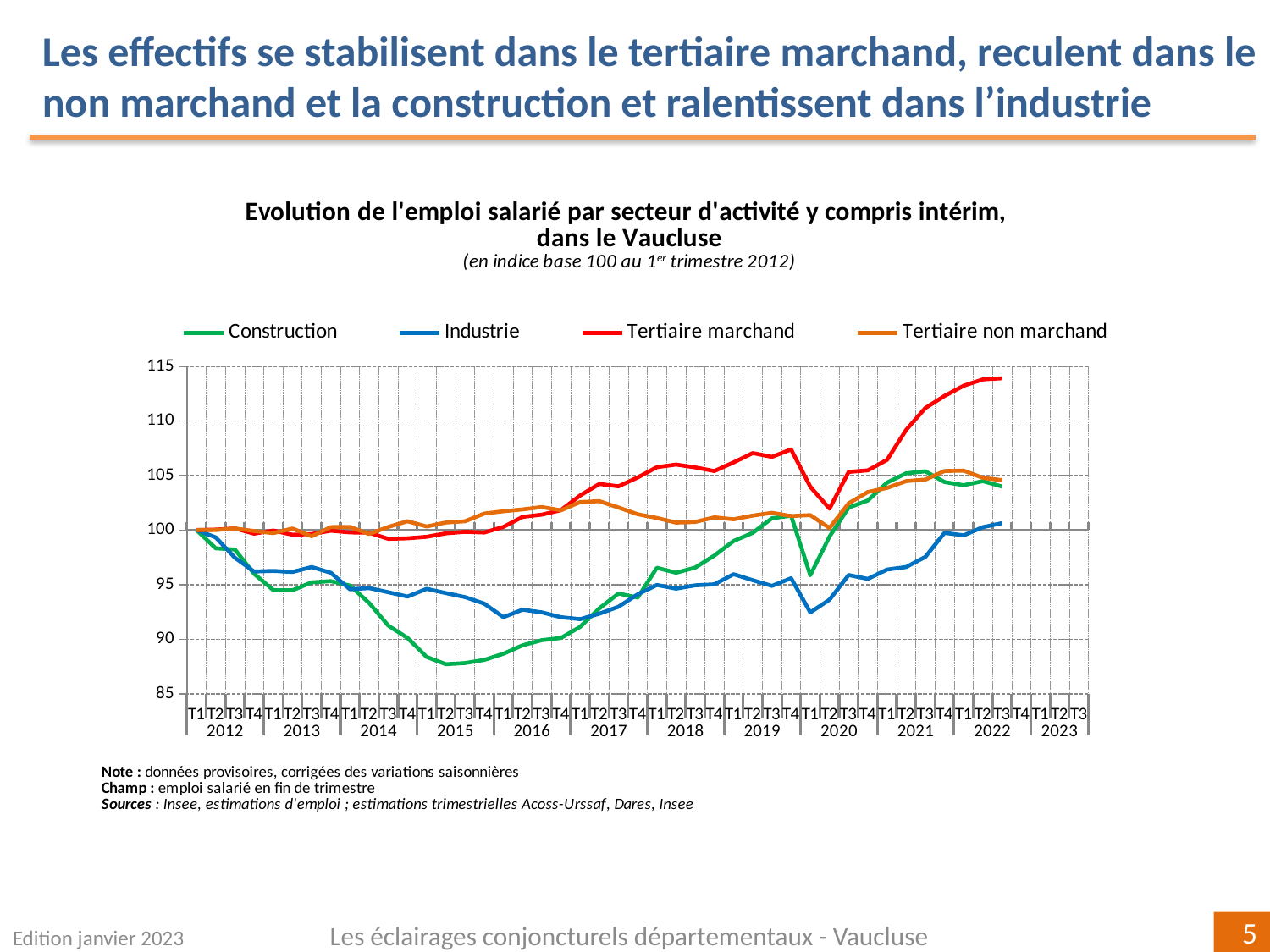
Which series has the lowest value at T3 2022? Industrie At T3 2022, which is larger: Tertiaire marchand or Industrie? Tertiaire marchand Which series reaches the lowest point anywhere on the chart? Construction Which series has the highest value at T3 2022? Tertiaire marchand Is the value for Construction at T2 2015 greater or less than 90? less Is the value for Industrie at T1 2020 greater or less than 95? less Does the Tertiaire marchand line rise or fall between T2 2020 and T3 2022? rise Is the value for Tertiaire marchand at T3 2022 greater or less than 110? greater What kind of chart is shown on the slide? line chart How many series does the legend list? 4 What colour is the Industrie line? blue